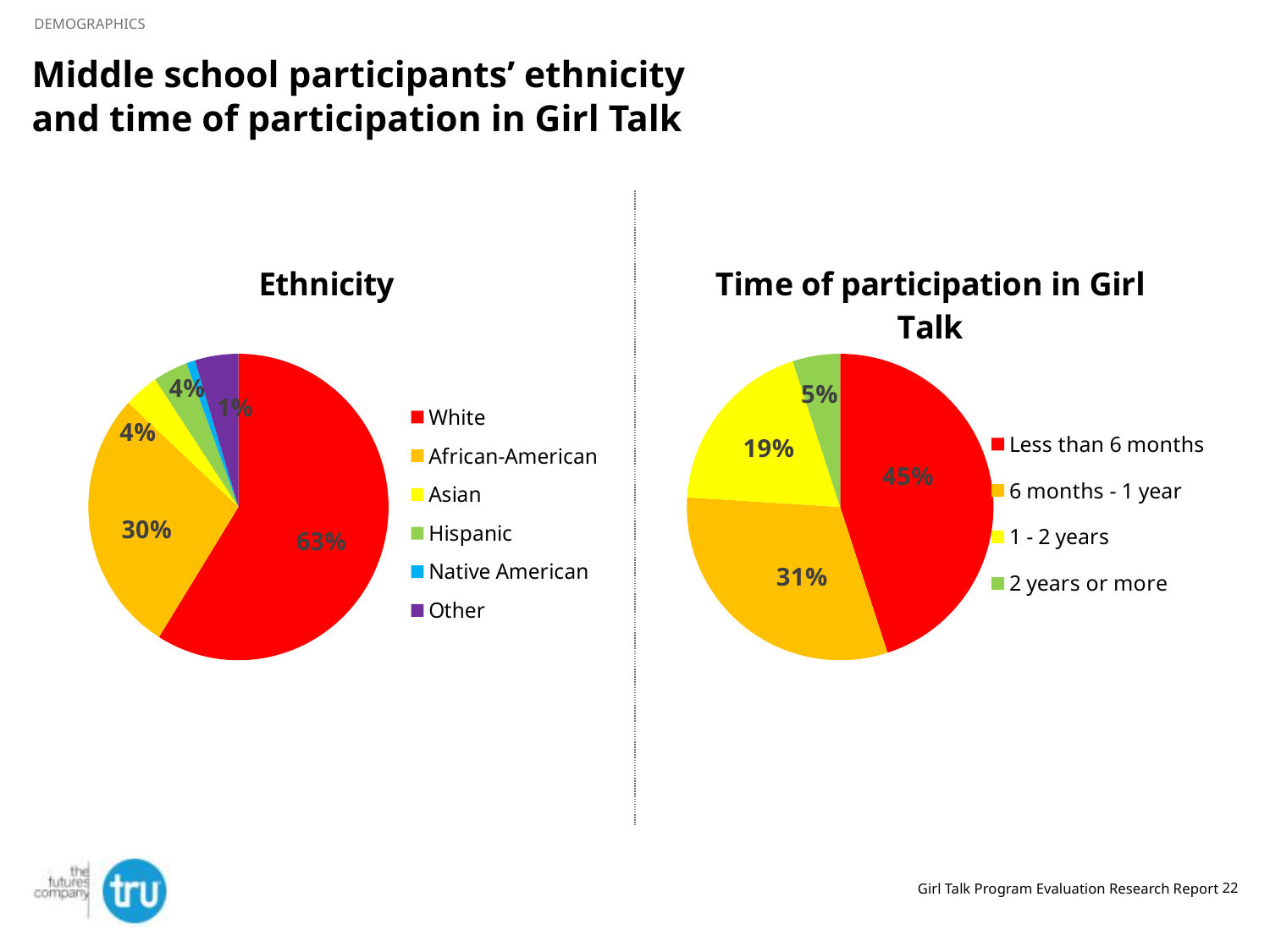
In the Time of participation in Girl Talk chart, which category has the smallest share? 2 years or more In the Time of participation in Girl Talk chart, what share of participants have participated for 1 - 2 years? 19% In the Ethnicity chart, which ethnicity has the largest share? White In the Ethnicity chart, what share of participants are African-American? 30% In the Ethnicity chart, what is the difference between the White and African-American shares? 33 percentage points In the Time of participation in Girl Talk chart, which is larger: 6 months - 1 year or 1 - 2 years? 6 months - 1 year In the Ethnicity chart, how many categories does the legend list? 6 In the Time of participation in Girl Talk chart, what share of participants have participated for less than 6 months? 45% In the Ethnicity chart, what share of participants are White? 63% In the Time of participation in Girl Talk chart, what colour represents 6 months - 1 year? Orange In the Time of participation in Girl Talk chart, what is the difference between the Less than 6 months and 2 years or more shares? 40 percentage points What type of chart is the Ethnicity chart? Pie chart